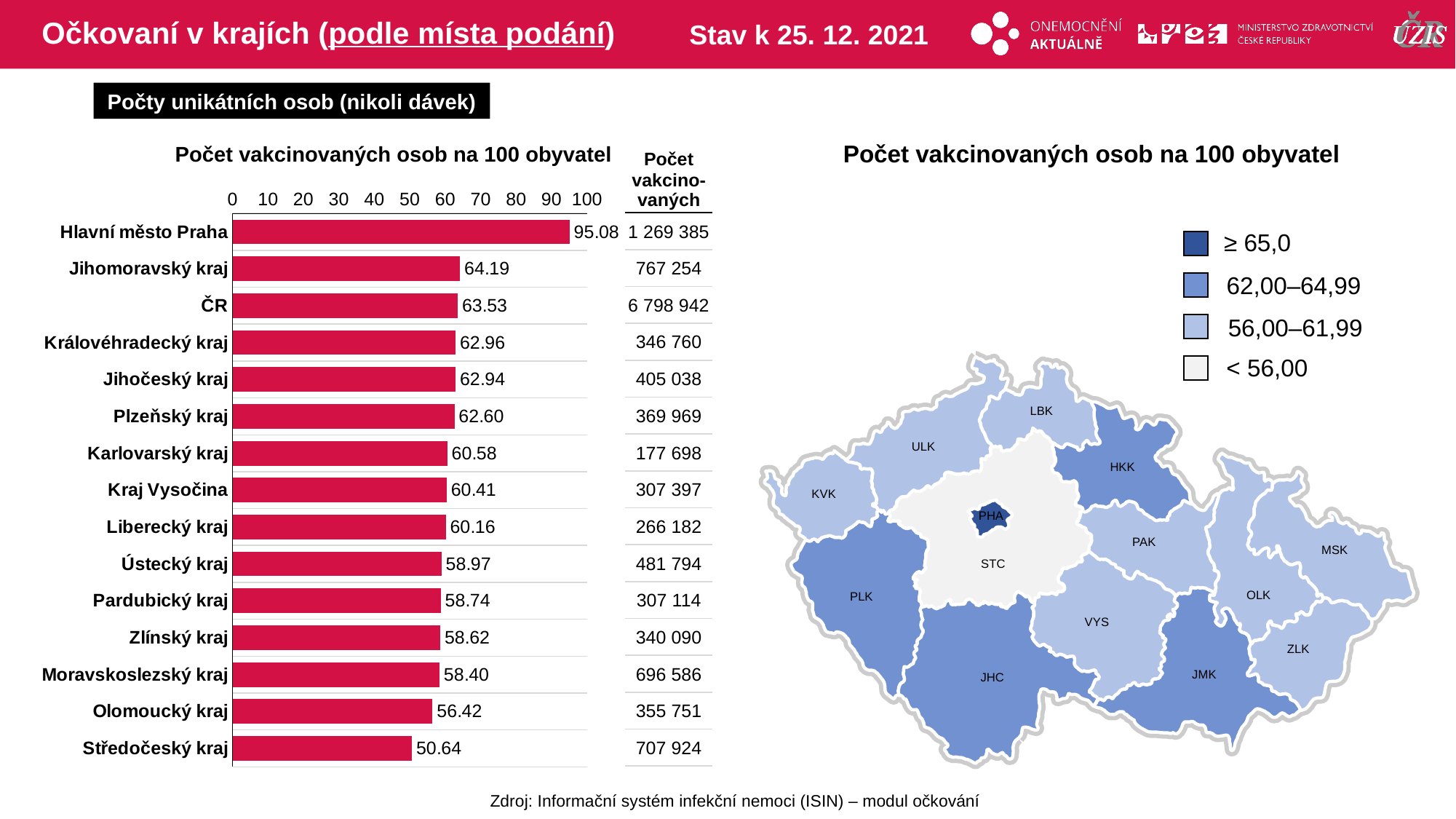
In the bar chart, what is the difference between the values for Hlavní město Praha and Středočeský kraj? 44.44 In the bar chart, which region has the highest number of vaccinated persons per 100 inhabitants? Hlavní město Praha In the bar chart, which has a higher value: Karlovarský kraj or Olomoucký kraj? Karlovarský kraj How many categories (bars) does the bar chart show? 15 In the bar chart, which region has the lowest number of vaccinated persons per 100 inhabitants? Středočeský kraj In the bar chart, what is the value for ČR? 63.53 What is the title of the bar chart on the left? Počet vakcinovaných osob na 100 obyvatel In the bar chart, what is the number of vaccinated persons per 100 inhabitants for Hlavní město Praha? 95.08 In the bar chart, what is the value for Středočeský kraj? 50.64 In the bar chart, is the value for Olomoucký kraj greater or less than 60? less What kind of chart is used on the left side of the slide to show the number of vaccinated persons per 100 inhabitants? bar chart In the bar chart, what is the value for Kraj Vysočina? 60.41